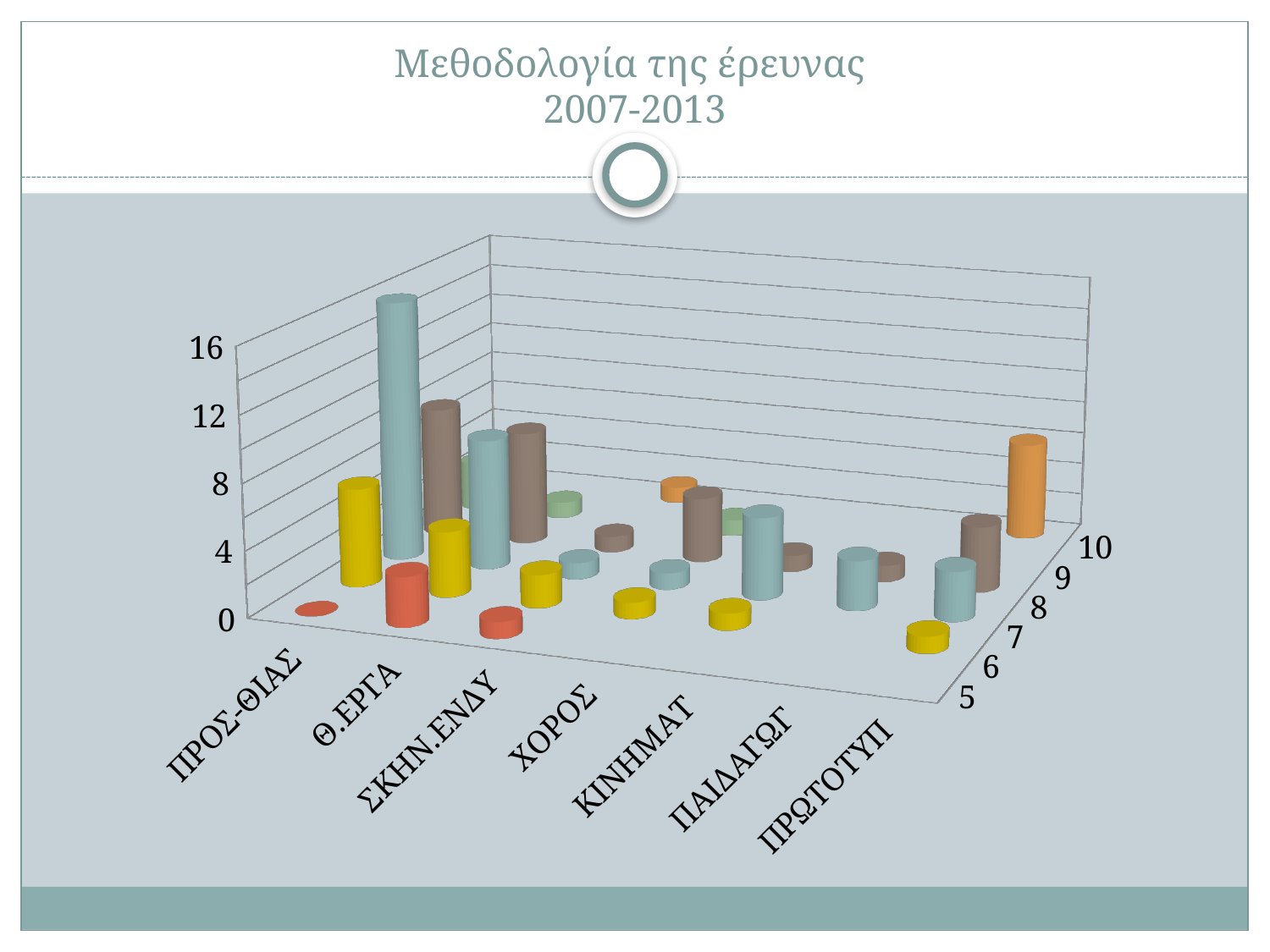
Which category has the tallest bar: Θ.ΕΡΓΑ or ΠΡΟΣ-ΘΙΑΣ? ΠΡΟΣ-ΘΙΑΣ Is the tallest bar in the ΠΡΟΣ-ΘΙΑΣ category greater or less than 4? greater Which category contains the tallest bar in the chart? ΠΡΟΣ-ΘΙΑΣ How many labels are shown on the depth axis of the chart? 6 What is the title of the chart on the slide? Μεθοδολογία της έρευνας 2007-2013 Is the tallest bar in the ΧΟΡΟΣ category greater or less than 8? less What is the first category label on the horizontal axis of the chart? ΠΡΟΣ-ΘΙΑΣ How many categories are labelled along the horizontal axis of the chart? 7 What is the last label on the depth axis of the chart? 10 Is the tallest bar in the Θ.ΕΡΓΑ category greater or less than 12? less What kind of chart is shown on the slide? bar chart What is the highest value labelled on the vertical axis of the chart? 16